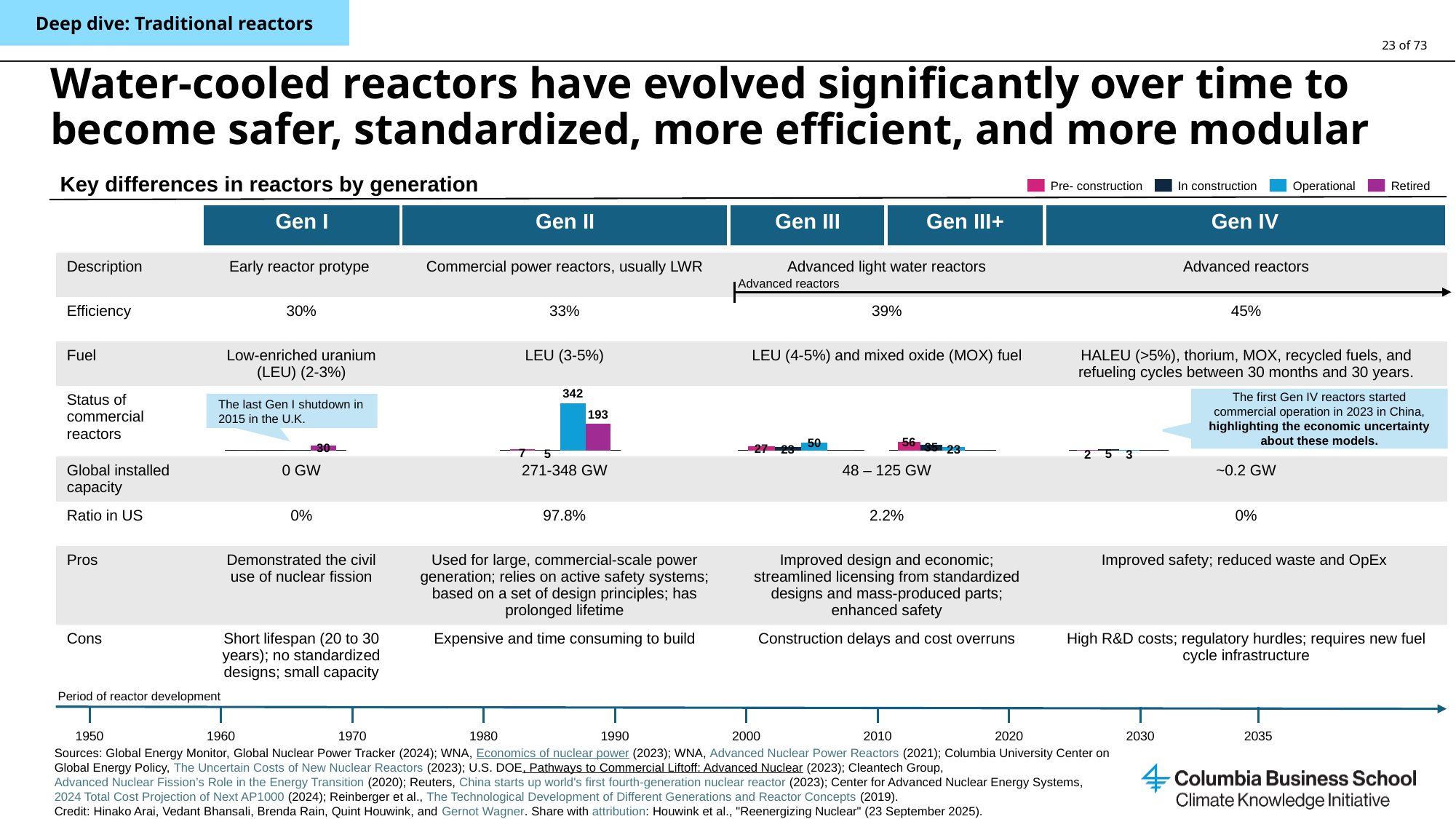
In the Gen IV status of commercial reactors chart, what is the value of the In construction bar? 5 In the Gen III status of commercial reactors chart, which is larger: Pre-construction or In construction? Pre-construction In the Gen III status of commercial reactors chart, what is the value of the Operational bar? 50 In the Gen II status of commercial reactors chart, what is the value of the Operational bar? 342 In the Gen III+ status of commercial reactors chart, which status has the lowest value? Operational How many statuses does the legend for the status of commercial reactors charts list? 4 In the Gen III+ status of commercial reactors chart, what is the value of the Pre-construction bar? 56 What type of chart is used to show the status of commercial reactors for each generation? Bar chart In the Gen I status of commercial reactors chart, what is the value of the Retired bar? 30 In the Gen II status of commercial reactors chart, which status has the highest value? Operational In the Gen II status of commercial reactors chart, what is the value of the Retired bar? 193 In the Gen II status of commercial reactors chart, what is the difference between the Operational and Retired values? 149